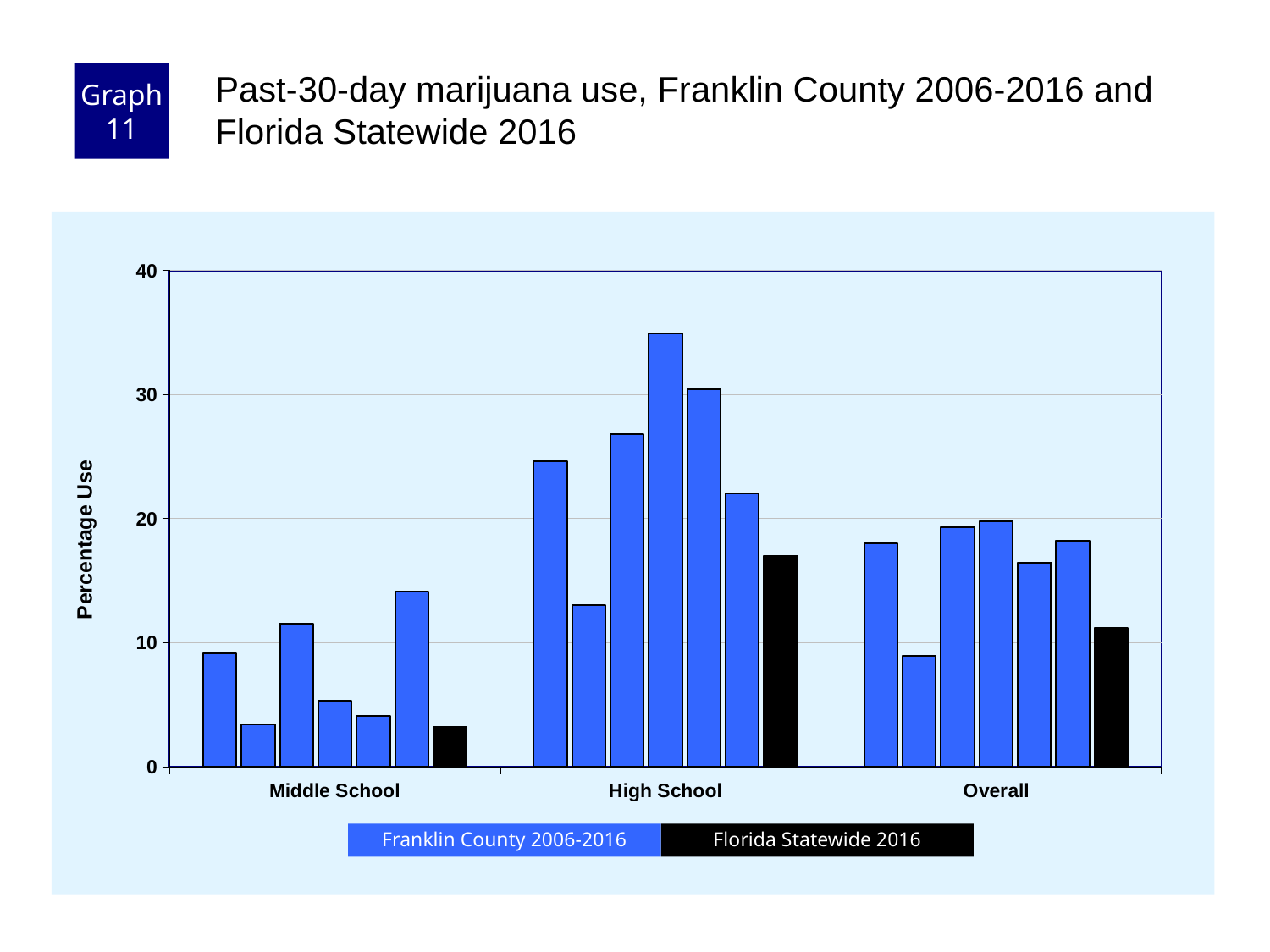
Is the Florida Statewide 2016 value for Overall greater or less than 20? less How many series does the legend list? 2 Is the Florida Statewide 2016 value for Middle School greater or less than 10? less Is the tallest Franklin County bar for Middle School greater or less than 20? less Which colour represents Florida Statewide 2016 in the legend? black What kind of chart is shown on the slide? bar chart Which is larger, the Florida Statewide 2016 value for High School or for Middle School? High School Which category has the tallest bar overall? High School What is the label of the y axis? Percentage Use How many categories are shown on the x axis? 3